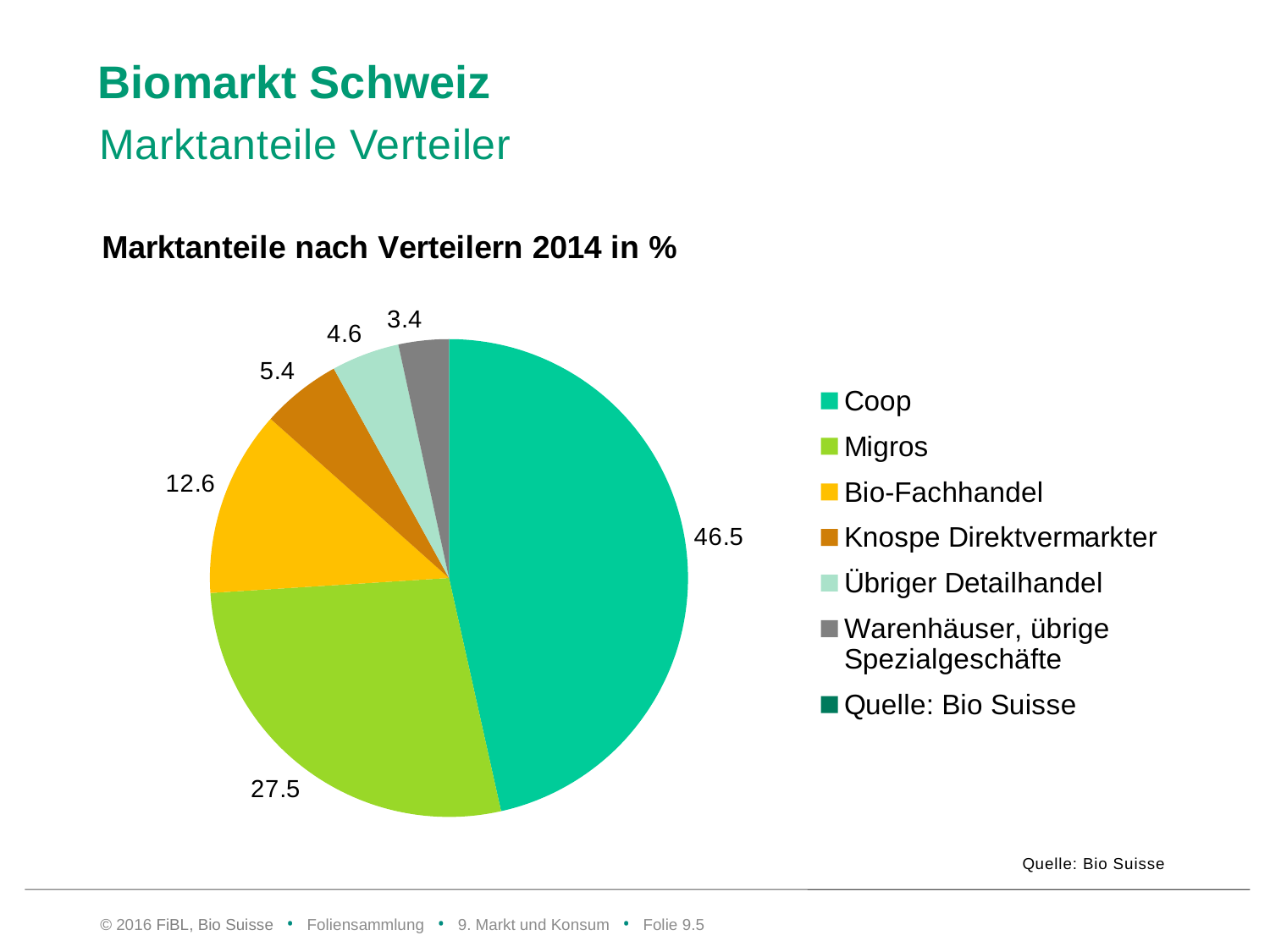
Which distributor has the smallest market share? Warenhäuser, übrige Spezialgeschäfte What is the market share of Coop in the pie chart? 46.5 What is the title of the chart? Marktanteile nach Verteilern 2014 in % What value is shown for Übriger Detailhandel? 4.6 What is the difference between the market shares of Coop and Migros? 19 What is the market share of Migros in the pie chart? 27.5 What value is shown for Knospe Direktvermarkter? 5.4 Which has a larger market share, Bio-Fachhandel or Knospe Direktvermarkter? Bio-Fachhandel How many slices with data labels does the pie chart have? 6 What value is shown for Bio-Fachhandel? 12.6 What kind of chart is shown on the slide? Pie chart Which distributor has the largest market share? Coop